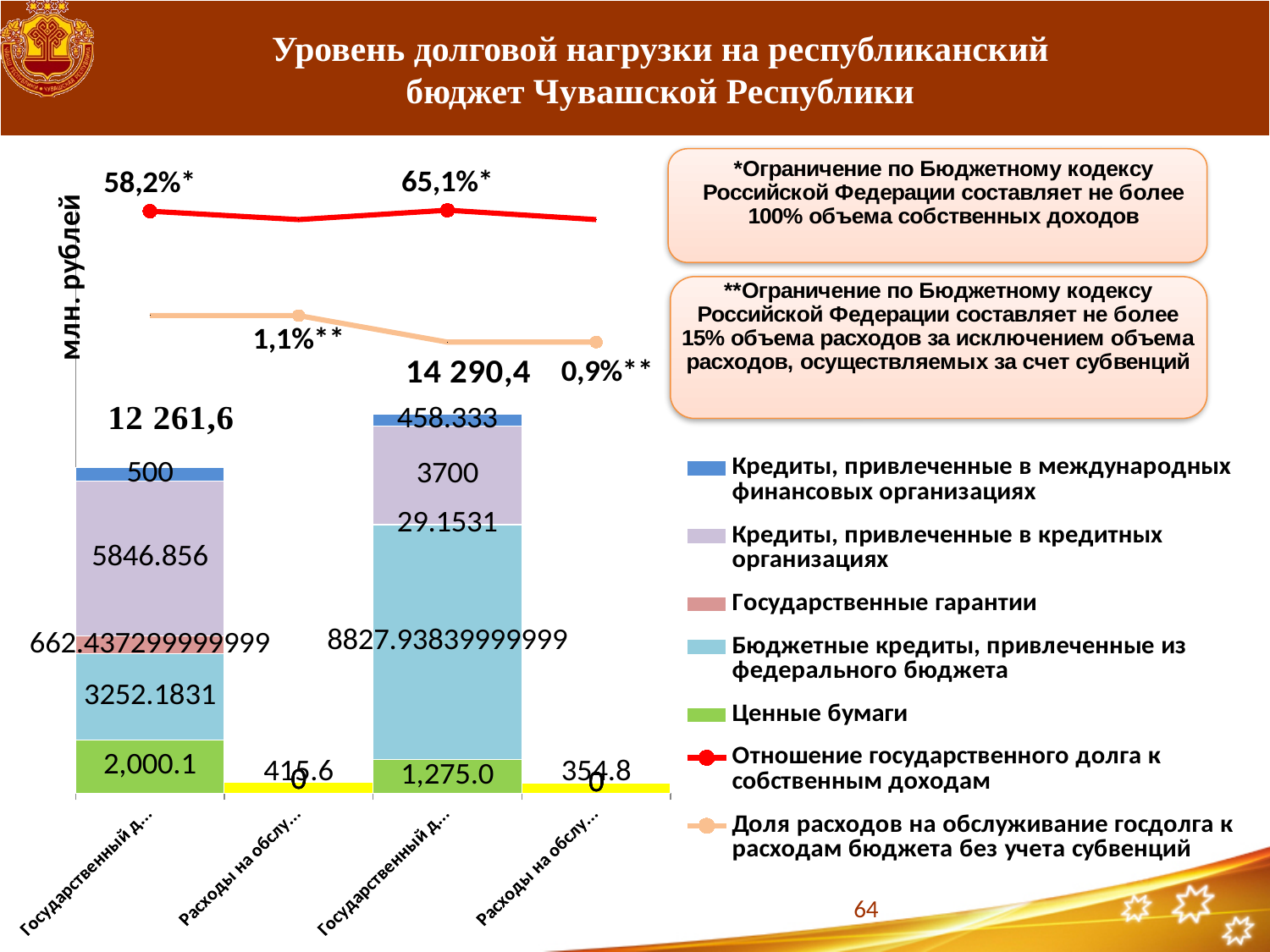
What is the value of the purple segment (Кредиты, привлеченные в кредитных организациях) in the left stacked bar? 5846.856 What is the value of the green segment (Ценные бумаги) in the left stacked bar? 2,000.1 What is the total printed above the left stacked bar? 12 261,6 Does the orange line (Доля расходов на обслуживание госдолга) rise or fall from left to right? fall What is the value of the green segment (Ценные бумаги) in the right stacked bar? 1,275.0 What is the total printed above the right stacked bar? 14 290,4 How many entries does the legend list? 7 What kind of chart is shown on the slide? combination bar and line chart What are the two values shown for the red line (Отношение государственного долга к собственным доходам)? 58,2%* and 65,1%* What is the value of the purple segment (Кредиты, привлеченные в кредитных организациях) in the right stacked bar? 3700 Which stacked bar has the larger total, the left one or the right one? the right one What is the value of the top blue segment (Кредиты, привлеченные в международных финансовых организациях) in the left stacked bar? 500